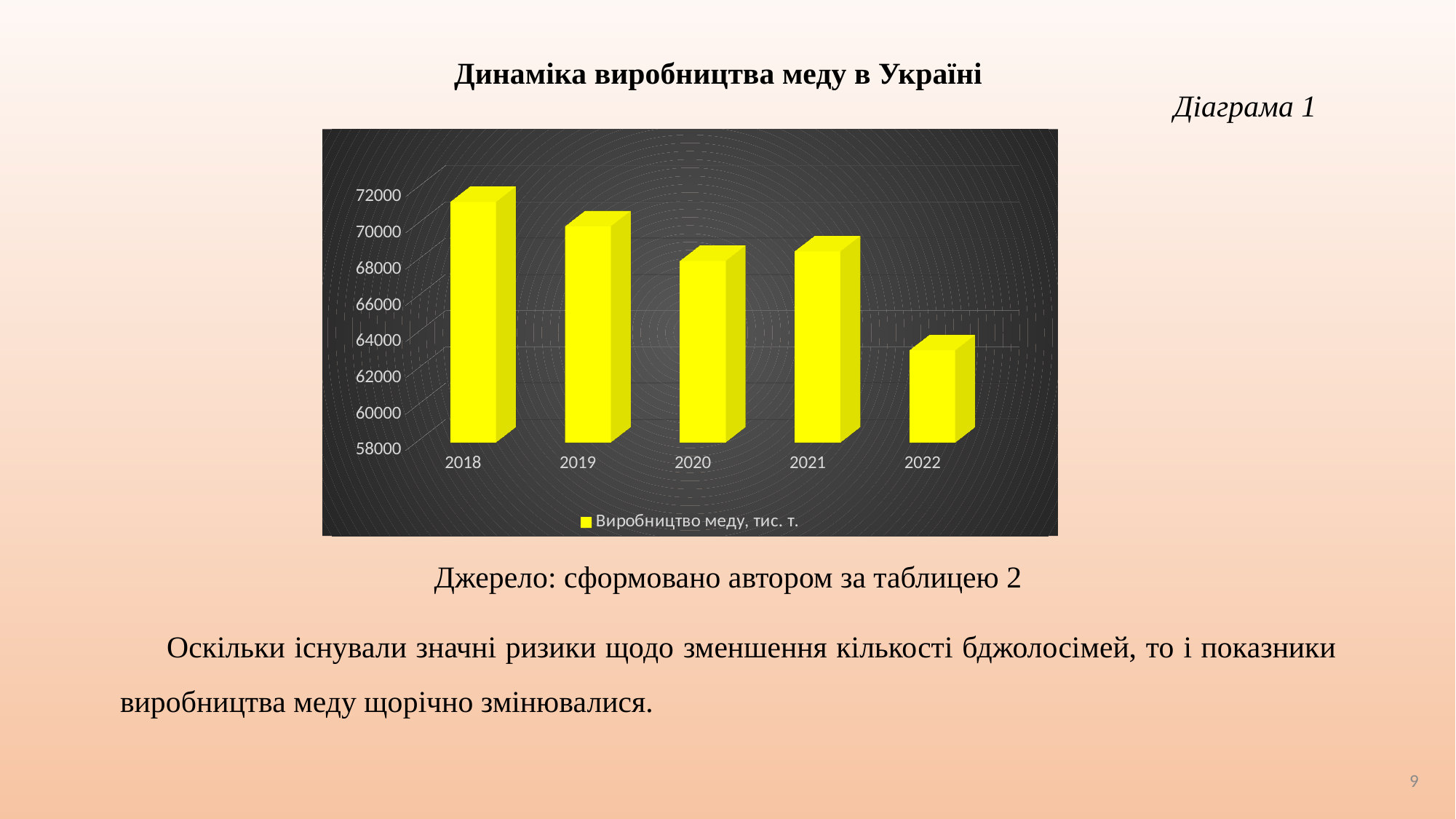
How many years are shown on the x axis of the chart? 5 Is the value for 2021 greater or less than 66000? greater How many series does the chart legend list? 1 Which year has the lowest honey production in the chart? 2022 Is the value for 2022 greater or less than 64000? less Which year has the highest honey production in the chart? 2018 Is the value for 2020 greater or less than 70000? less What kind of chart is shown on the slide? Bar chart Do the values generally rise or fall from 2018 to 2022? Fall Which year has the larger value, 2019 or 2021? 2019 What is the legend entry of the chart? Виробництво меду, тис. т.